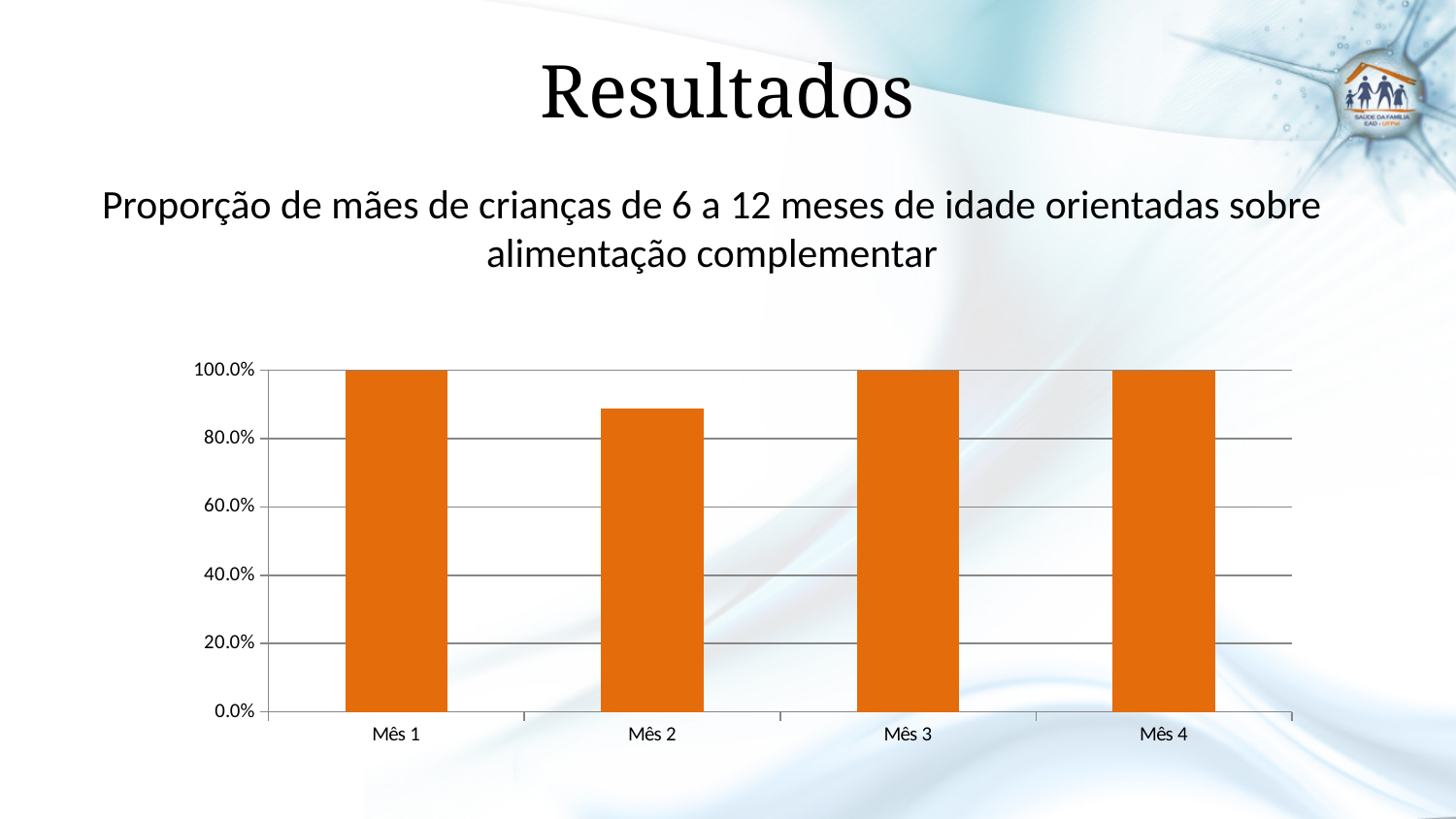
Which month has the lowest value? Mês 2 What is the value for Mês 4? 100.0% Is the value for Mês 2 greater or less than 100.0%? less What colour are the bars in the chart? orange Which is larger, the value for Mês 1 or the value for Mês 2? Mês 1 What is the value for Mês 3? 100.0% What is the value for Mês 1? 100.0% Which is larger, the value for Mês 2 or the value for Mês 4? Mês 4 Is the value for Mês 2 greater or less than 80.0%? greater How many categories (months) are shown on the x axis of the chart? 4 What kind of chart is shown on the slide? bar chart What is the highest value shown on the y axis of the chart? 100.0%